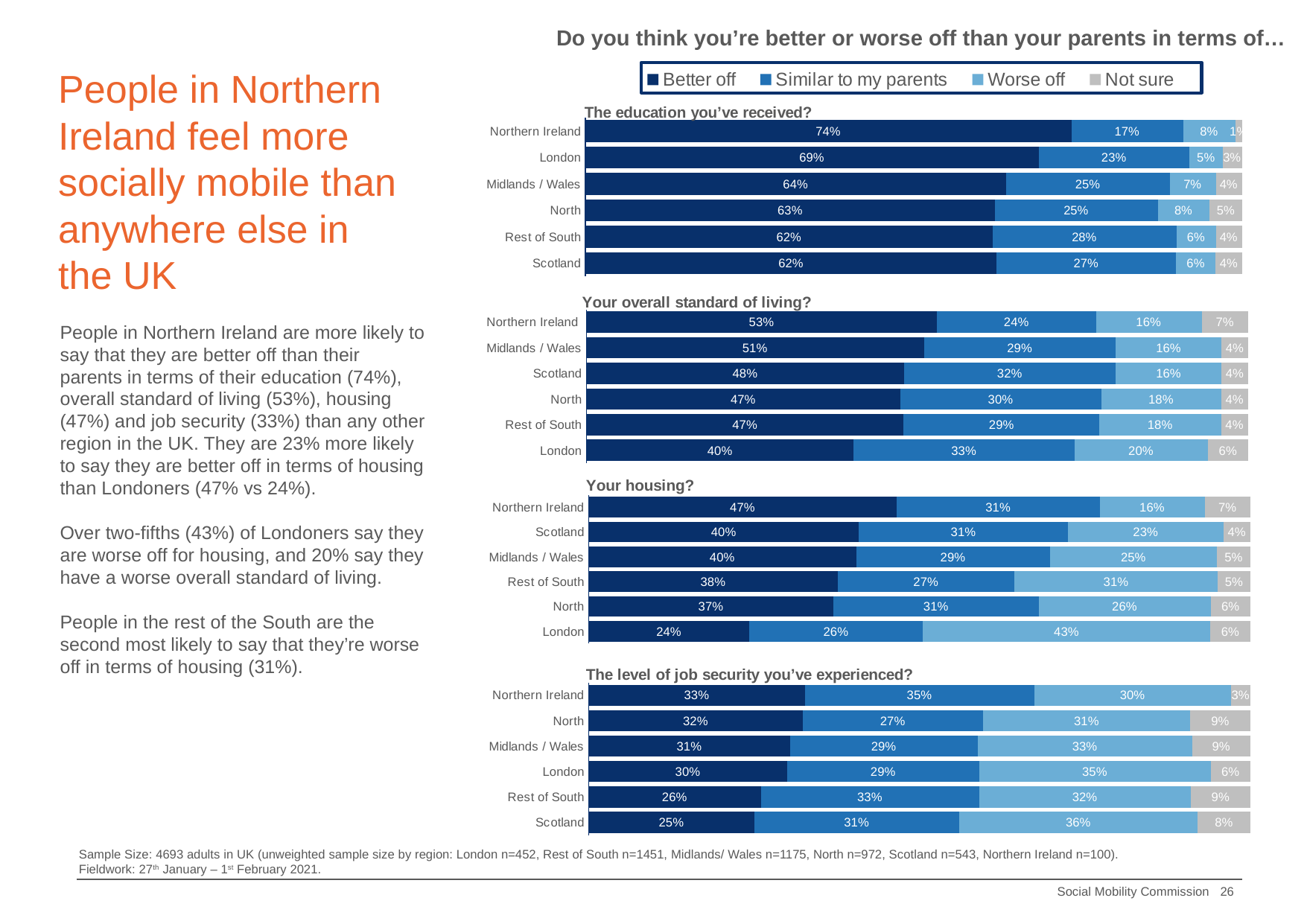
What kind of chart is used for 'Your overall standard of living?' Stacked bar chart In the chart 'The level of job security you've experienced?', which is larger: the 'Worse off' value for Scotland or for Northern Ireland? Scotland How many series does the legend list? 4 Which legend entry is shown in the lightest grey colour? Not sure In the chart 'The education you've received?', what percentage of people in Northern Ireland say they are better off? 74% In the chart 'The level of job security you've experienced?', what percentage of people in Scotland say they are similar to their parents? 31% In the chart 'Your housing?', which region has the lowest 'Better off' value? London In the chart 'Your housing?', what percentage of Londoners say they are worse off? 43% In the chart 'Your overall standard of living?', what is the total of the 'Better off' and 'Similar to my parents' values for London? 73% How many regions are shown in the chart 'The education you've received?' 6 In the chart 'Your housing?', what is the difference between the 'Better off' values for Northern Ireland and London? 23% In the chart 'Your overall standard of living?', which region has the highest 'Better off' value? Northern Ireland